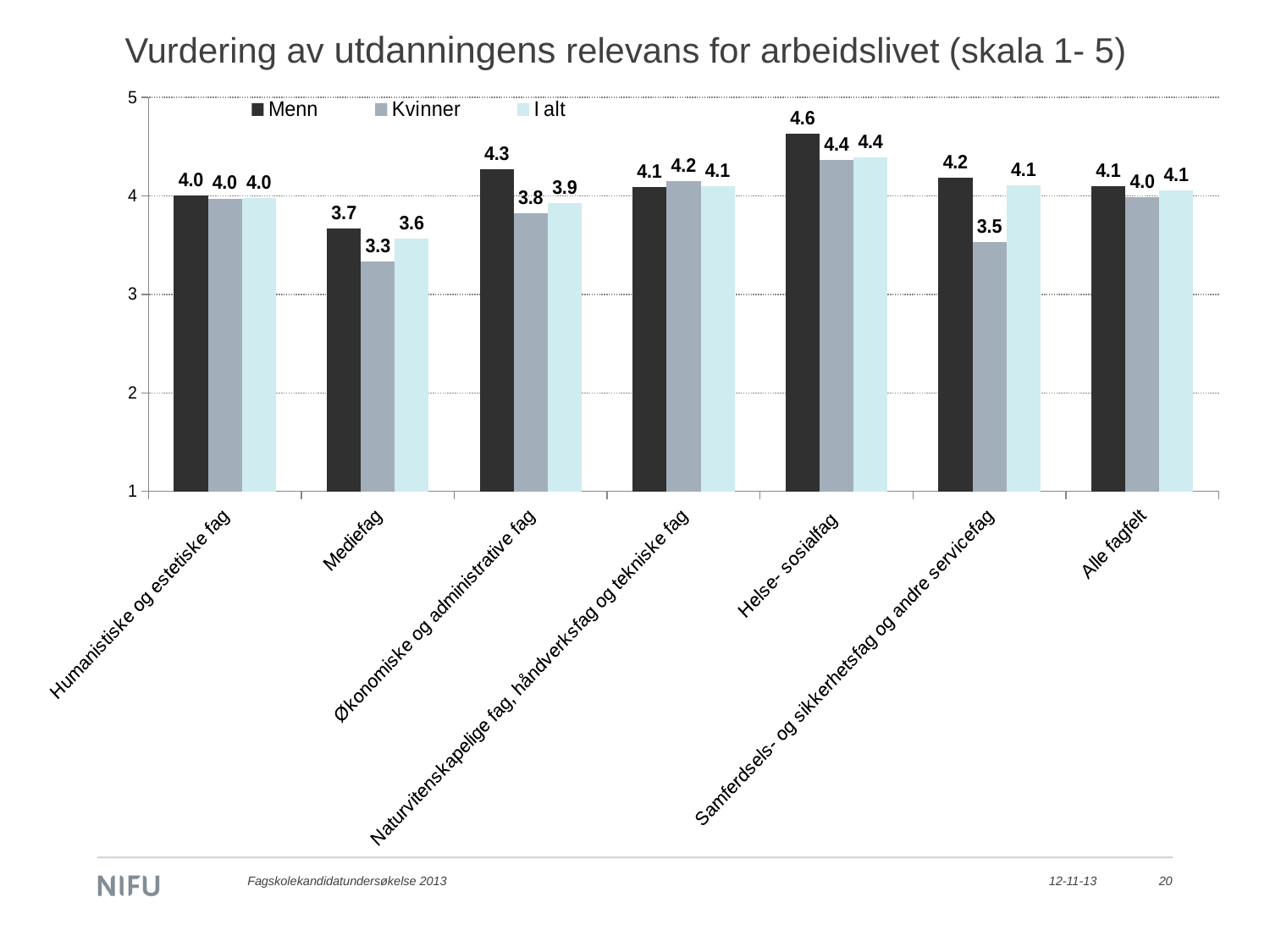
Which category has the lowest value for Kvinner? Mediefag What is the value for I alt in Økonomiske og administrative fag? 3.9 How many series does the legend list? 3 What kind of chart is shown on the slide? Bar chart What is the value for Kvinner in Samferdsels- og sikkerhetsfag og andre servicefag? 3.5 What is the value for Kvinner in Mediefag? 3.3 What is the title of the chart? Vurdering av utdanningens relevans for arbeidslivet (skala 1- 5) What is the difference between the Menn and Kvinner values in Samferdsels- og sikkerhetsfag og andre servicefag? 0.7 What is the value for Menn in Helse- sosialfag? 4.6 Which is larger in Naturvitenskapelige fag, håndverksfag og tekniske fag: the value for Menn or for Kvinner? Kvinner Which category has the highest value for Menn? Helse- sosialfag How many categories are shown on the x axis? 7